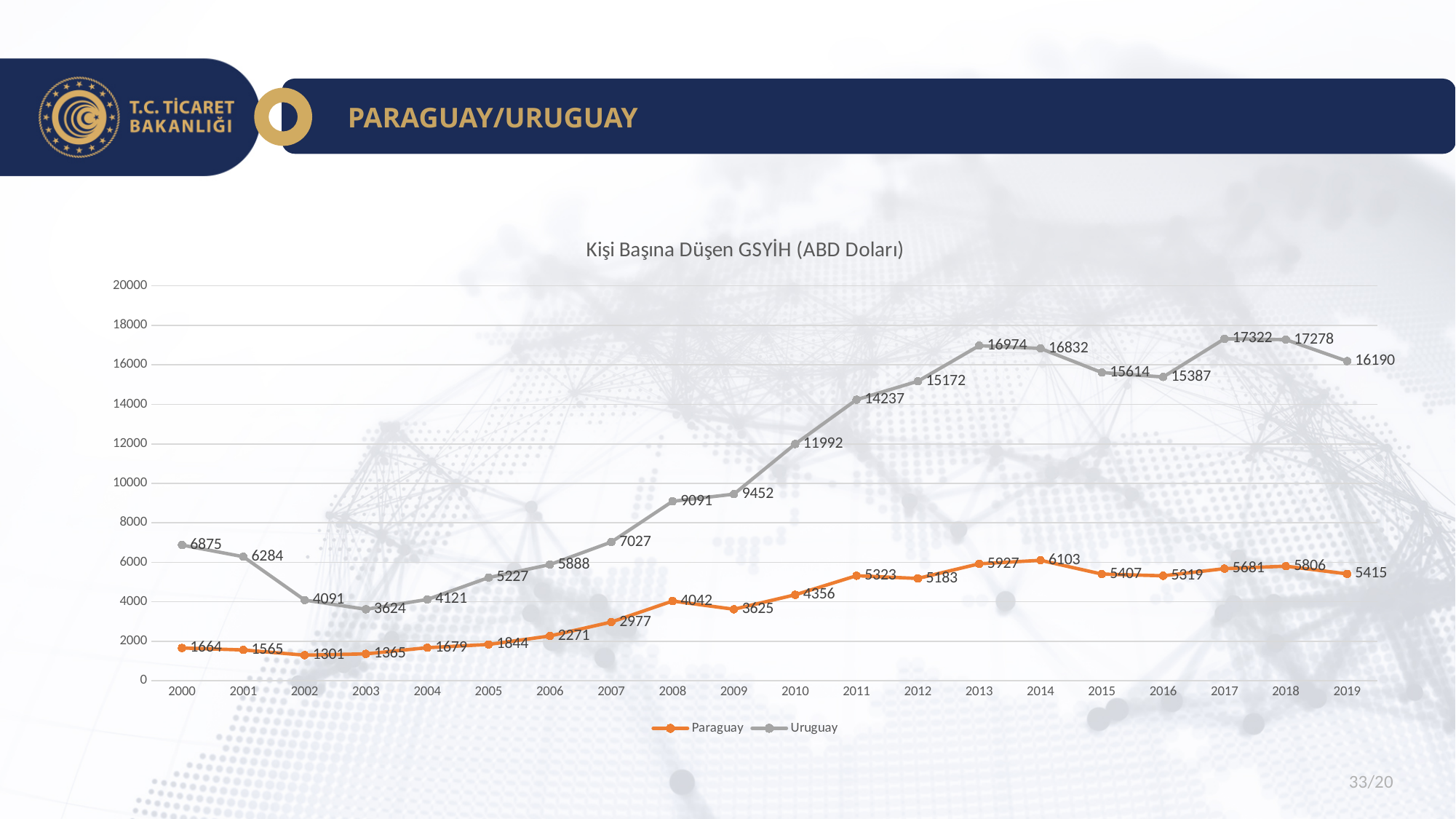
What type of chart is shown on the slide? Line chart In which year does Paraguay have its lowest value? 2002 Which series has the larger value in 2003, Paraguay or Uruguay? Uruguay What is the title of the chart? Kişi Başına Düşen GSYİH (ABD Doları) How many series does the legend list? 2 Is the value for Uruguay in 2013 greater or less than 16000? greater What is the value for Uruguay in 2010? 11992 How many years are plotted on the x axis? 20 What is the value for Paraguay in 2008? 4042 Does the Paraguay series generally rise or fall from 2002 to 2014? Rise What is the difference between Uruguay and Paraguay in 2019? 10775 In which year does Uruguay reach its highest value? 2017